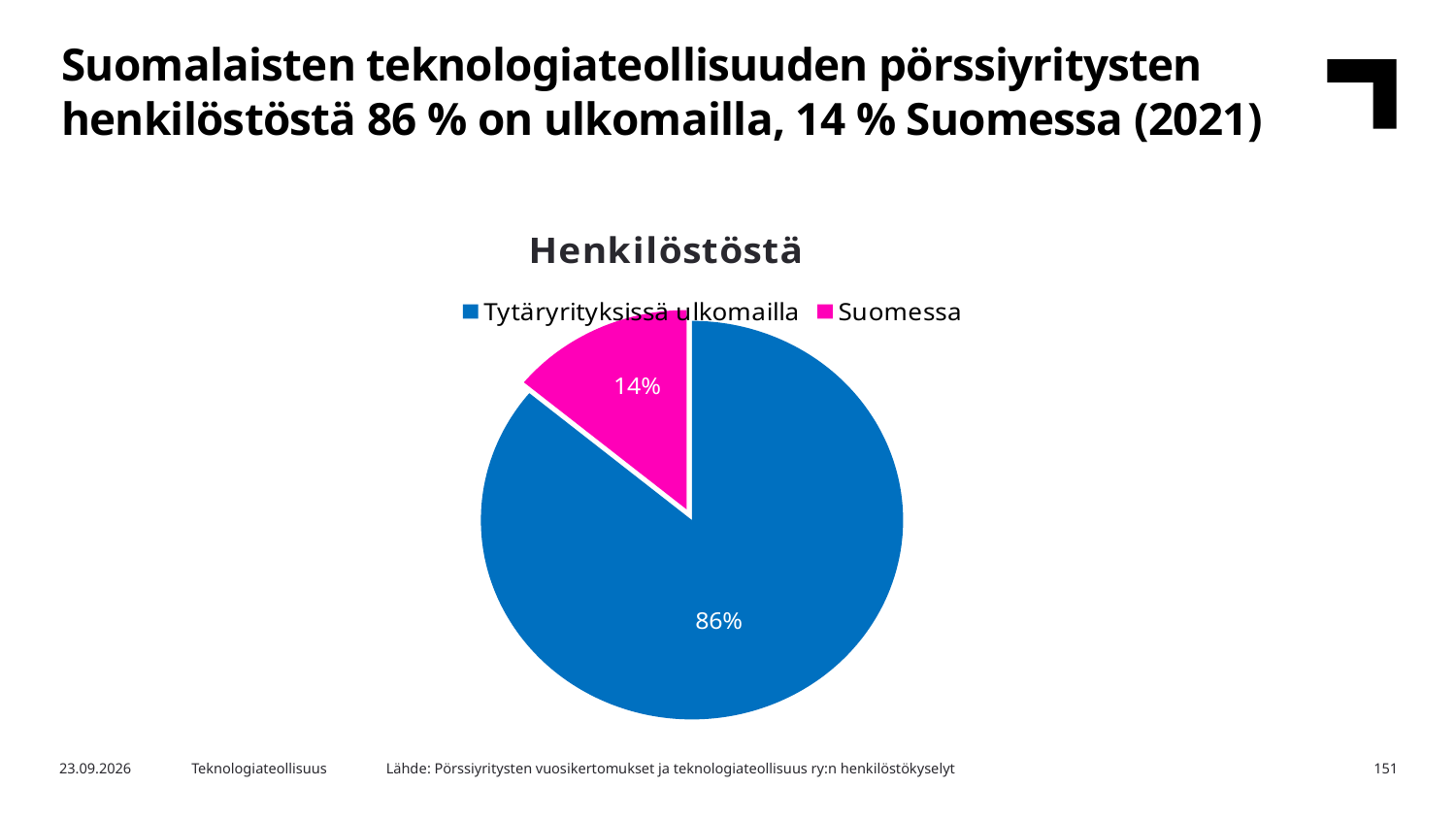
What is the difference in percentage points between the Tytäryrityksissä ulkomailla slice and the Suomessa slice? 72 percentage points Which slice of the pie is the largest? Tytäryrityksissä ulkomailla How many entries does the legend list? 2 How many slices does the pie chart have? 2 What colour is the Suomessa slice in the pie chart? Pink (magenta) Which slice of the pie is the smallest? Suomessa What is the title of the chart? Henkilöstöstä What kind of chart is shown on the slide? Pie chart What share of the pie does the Suomessa slice represent? 14% Which is larger, the Suomessa slice or the Tytäryrityksissä ulkomailla slice? Tytäryrityksissä ulkomailla What share of the pie does the Tytäryrityksissä ulkomailla slice represent? 86%